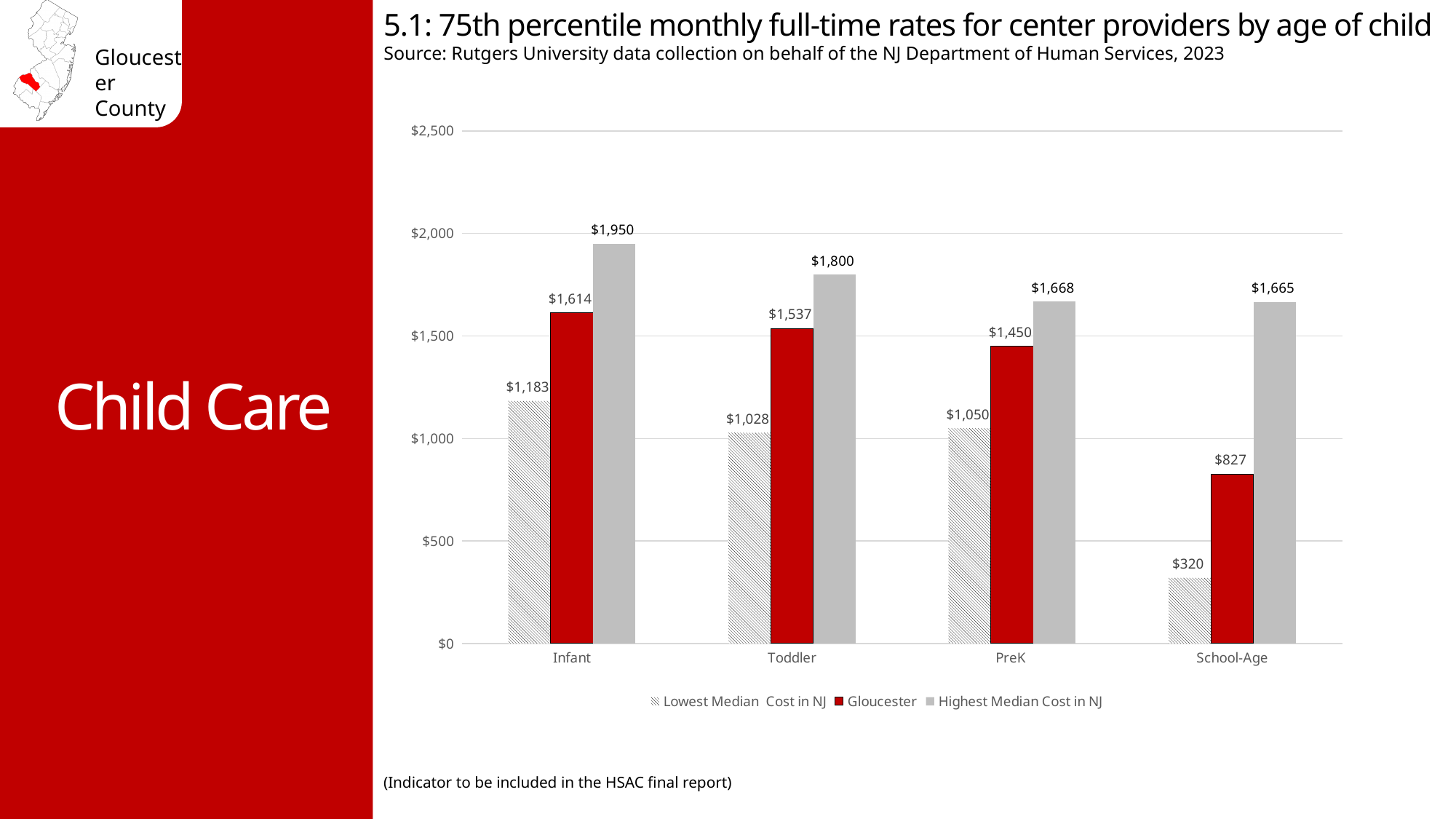
Which age group has the lowest Lowest Median Cost in NJ value? School-Age What is the Lowest Median Cost in NJ for School-Age? $320 What is the difference between the Highest Median Cost in NJ and the Gloucester value for PreK? $218 How many age groups are shown on the x axis? 4 Is the Gloucester value for School-Age greater or less than $1,000? less What is the Gloucester value for Infant? $1,614 Do the Gloucester values rise or fall from Infant to School-Age? Fall What kind of chart is shown on the slide? Bar chart What is the Highest Median Cost in NJ for Toddler? $1,800 How many series does the legend list? 3 Which age group has the highest Gloucester value? Infant Which is larger for Toddler: the Gloucester value or the Lowest Median Cost in NJ? Gloucester